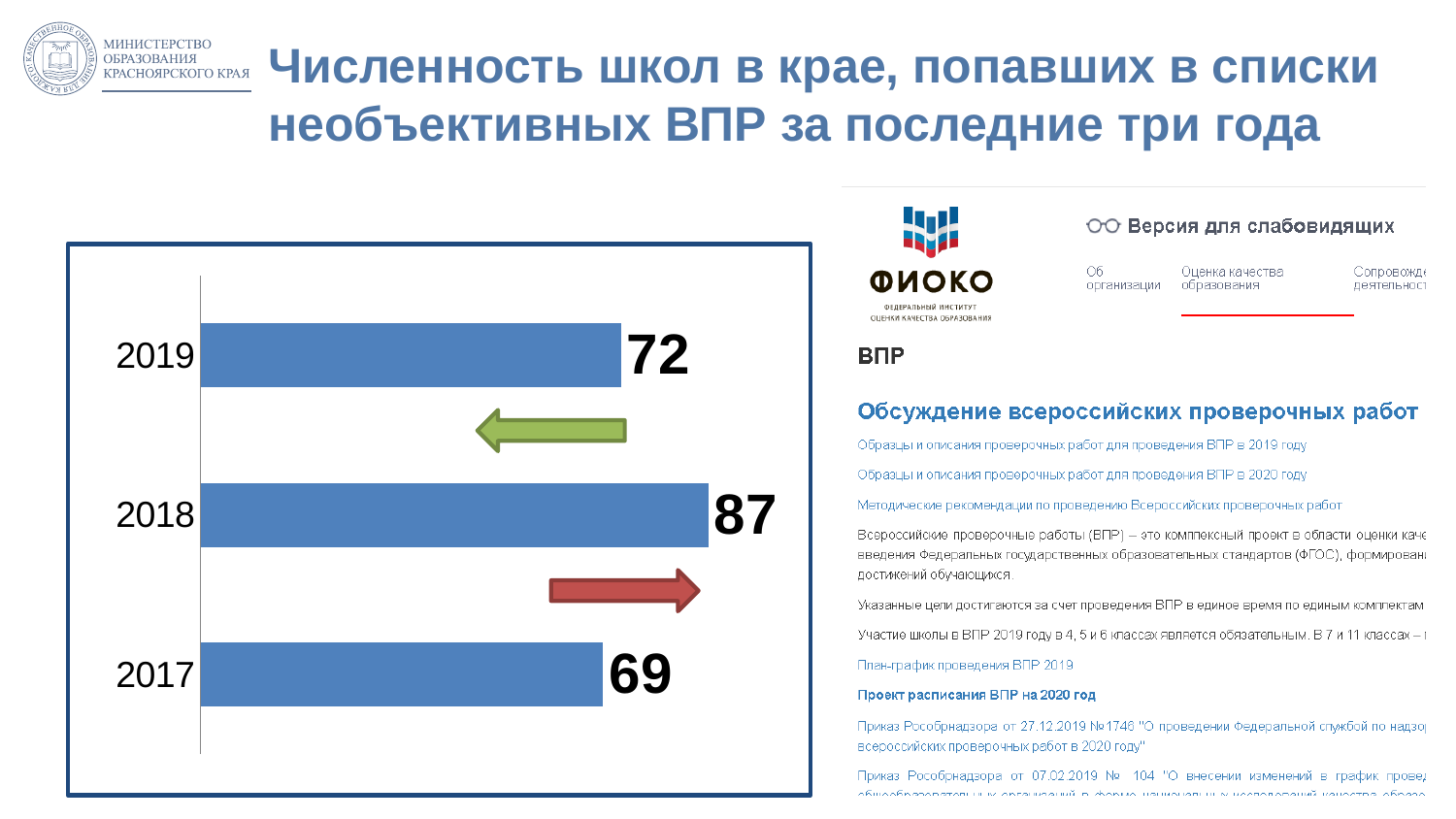
What colour are the bars in the chart? blue What is the value for 2019? 72 What is the value for 2017? 69 Which year has the lowest value? 2017 How many years are shown in the chart? 3 What kind of chart is shown on the slide? bar chart What is the value for 2018? 87 What is the difference between the values for 2018 and 2019? 15 Which is larger, the value for 2019 or the value for 2017? 2019 Did the value rise or fall from 2017 to 2018? rise Which year has the highest value? 2018 What is the difference between the values for 2018 and 2017? 18